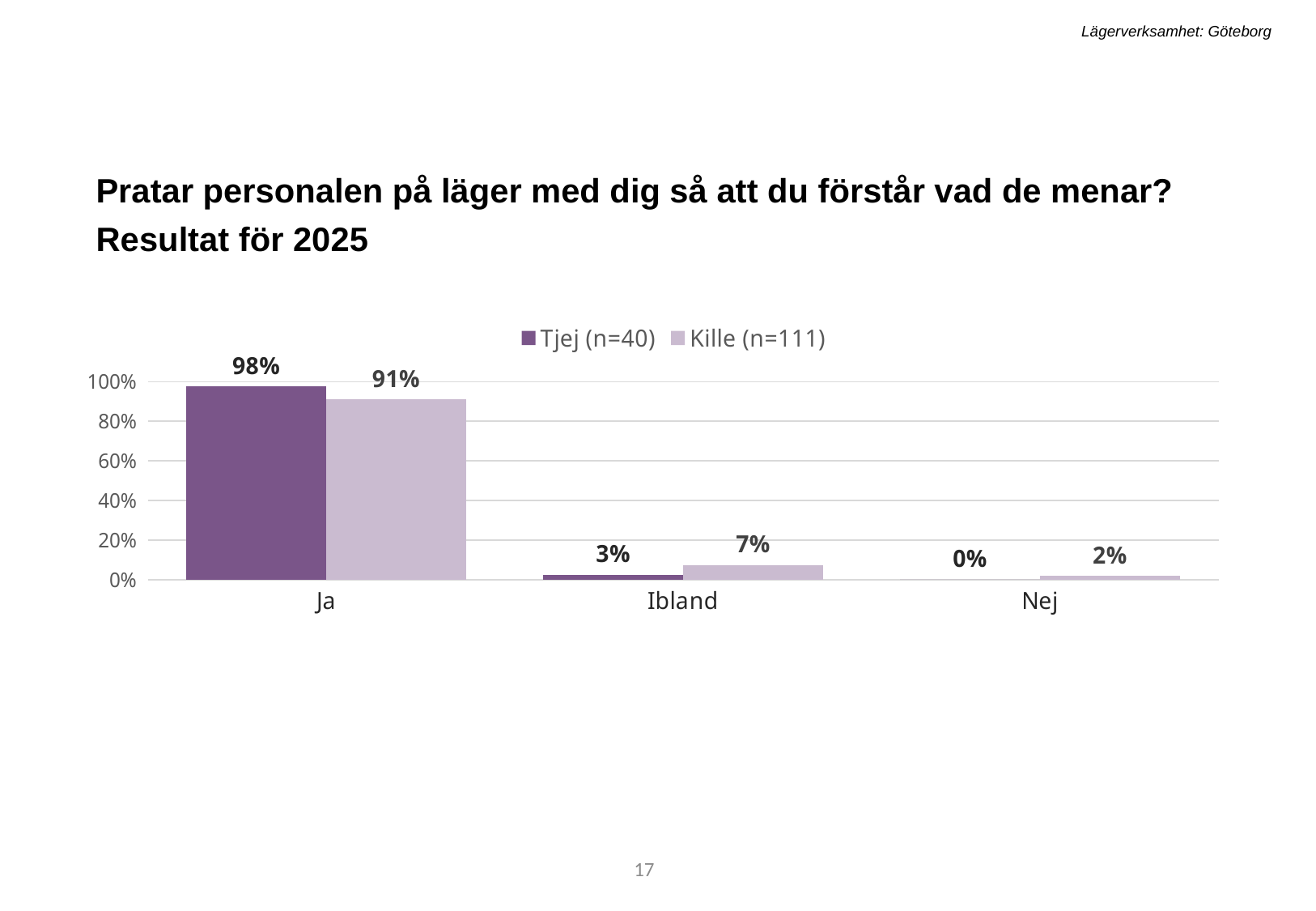
How many categories are shown on the x axis? 3 Is the value for Kille (n=111) in the Ja category greater or less than 80%? greater What kind of chart is shown on the slide? Bar chart What is the value for Kille (n=111) in the Ibland category? 7% How many series does the legend list? 2 In the Ibland category, which series has the larger value, Tjej (n=40) or Kille (n=111)? Kille (n=111) What is the difference between the Tjej (n=40) and Kille (n=111) values in the Ja category? 7 percentage points Which category has the lowest value for Tjej (n=40)? Nej What is the value for Tjej (n=40) in the Ja category? 98% What is the value for Tjej (n=40) in the Nej category? 0% Which category has the highest value for Kille (n=111)? Ja What is the value for Kille (n=111) in the Nej category? 2%